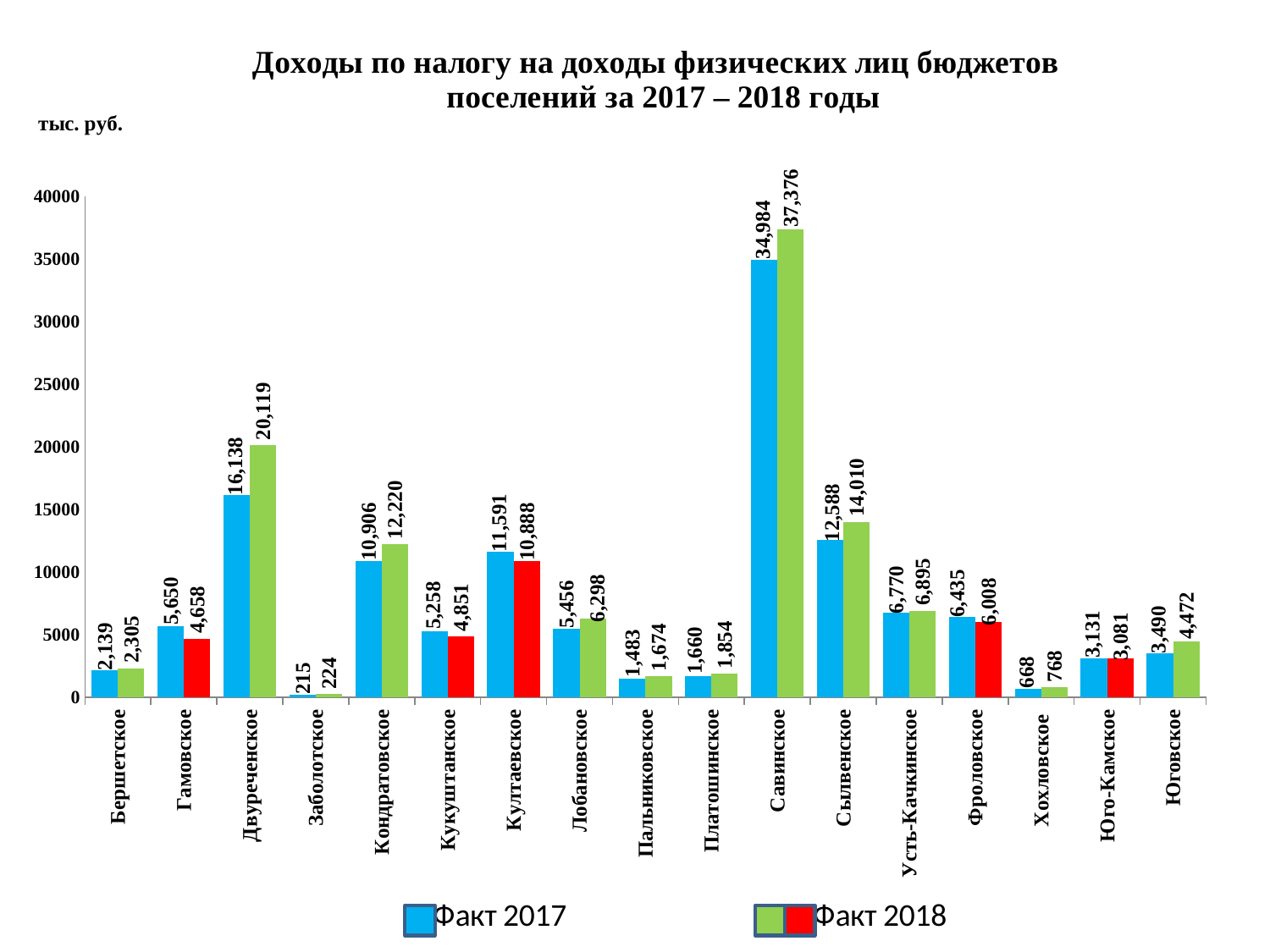
How many settlements are shown on the x axis? 17 What is the difference between the Факт 2018 and Факт 2017 values for Савинское? 2,392 What is the difference between the Факт 2018 and Факт 2017 values for Двуреченское? 3,981 Is the Факт 2018 value for Сылвенское greater or less than 15000? less What kind of chart is shown on the slide? bar chart What is the Факт 2018 value for Двуреченское? 20,119 What is the Факт 2017 value for Савинское? 34,984 How many series does the legend list? 2 For Гамовское, which is larger: the Факт 2017 value or the Факт 2018 value? Факт 2017 Which settlement has the lowest Факт 2017 value? Заболотское What is the Факт 2018 value for Хохловское? 768 Which settlement has the highest Факт 2018 value? Савинское